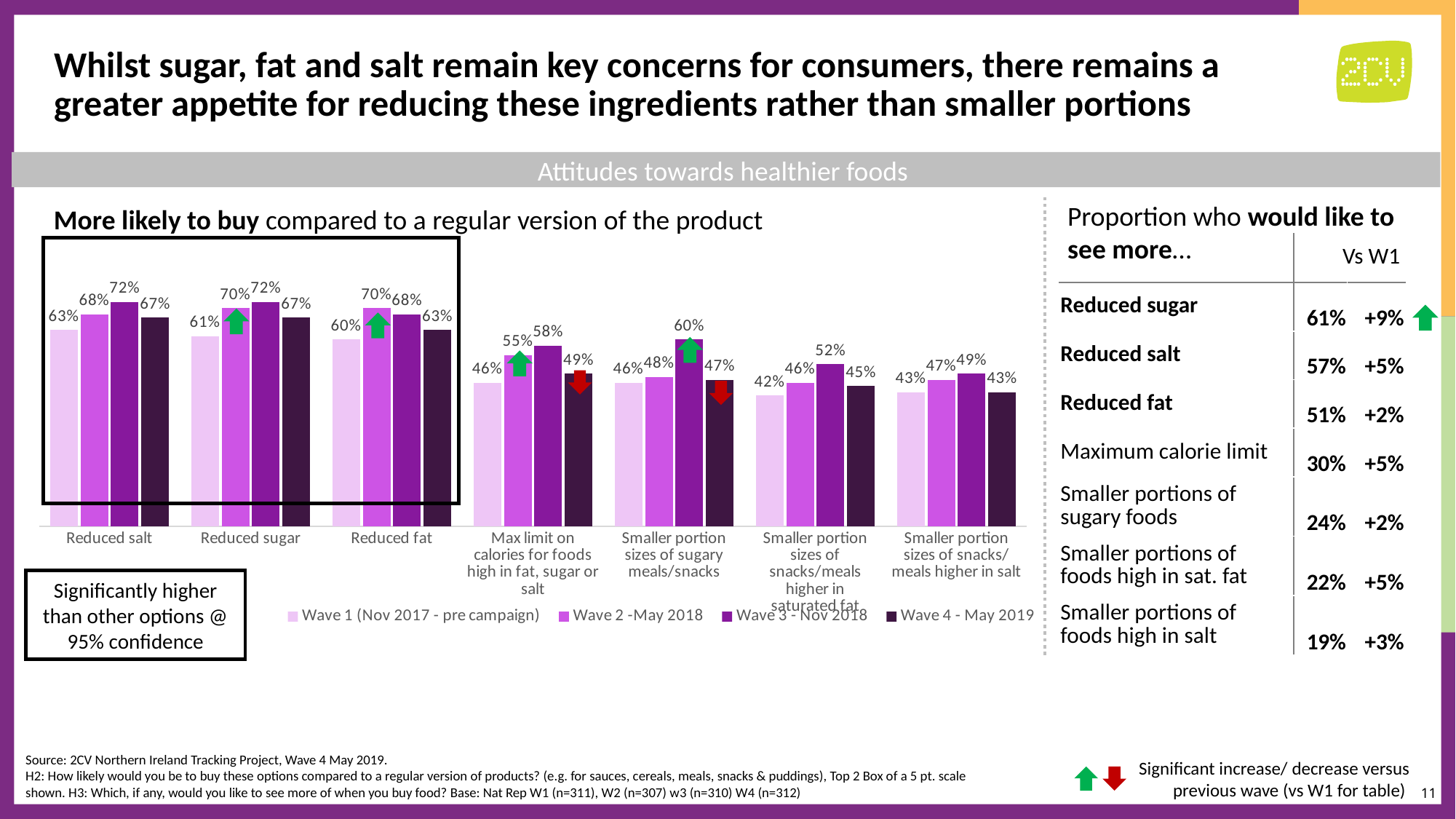
How many categories are shown on the x axis of the chart? 7 What kind of chart is shown on the slide? Bar chart What is the difference between the Wave 3 - Nov 2018 and Wave 4 - May 2019 values for Smaller portion sizes of sugary meals/snacks? 13 percentage points What is the Wave 1 (Nov 2017 - pre campaign) value for Reduced fat? 60% Which is larger: the Wave 3 - Nov 2018 value for Reduced salt or the Wave 3 - Nov 2018 value for Reduced fat? Reduced salt How many series does the chart legend list? 4 Across the four waves, do the values for Reduced sugar rise or fall from Wave 3 - Nov 2018 to Wave 4 - May 2019? Fall What is the Wave 3 - Nov 2018 value for Smaller portion sizes of sugary meals/snacks? 60% What is the Wave 4 - May 2019 value for Reduced salt? 67% Which category has the lowest Wave 1 (Nov 2017 - pre campaign) value? Smaller portion sizes of snacks/meals higher in saturated fat Which category has the highest Wave 2 - May 2018 value? Reduced sugar and Reduced fat (both 70%) What is the Wave 2 - May 2018 value for Max limit on calories for foods high in fat, sugar or salt? 55%